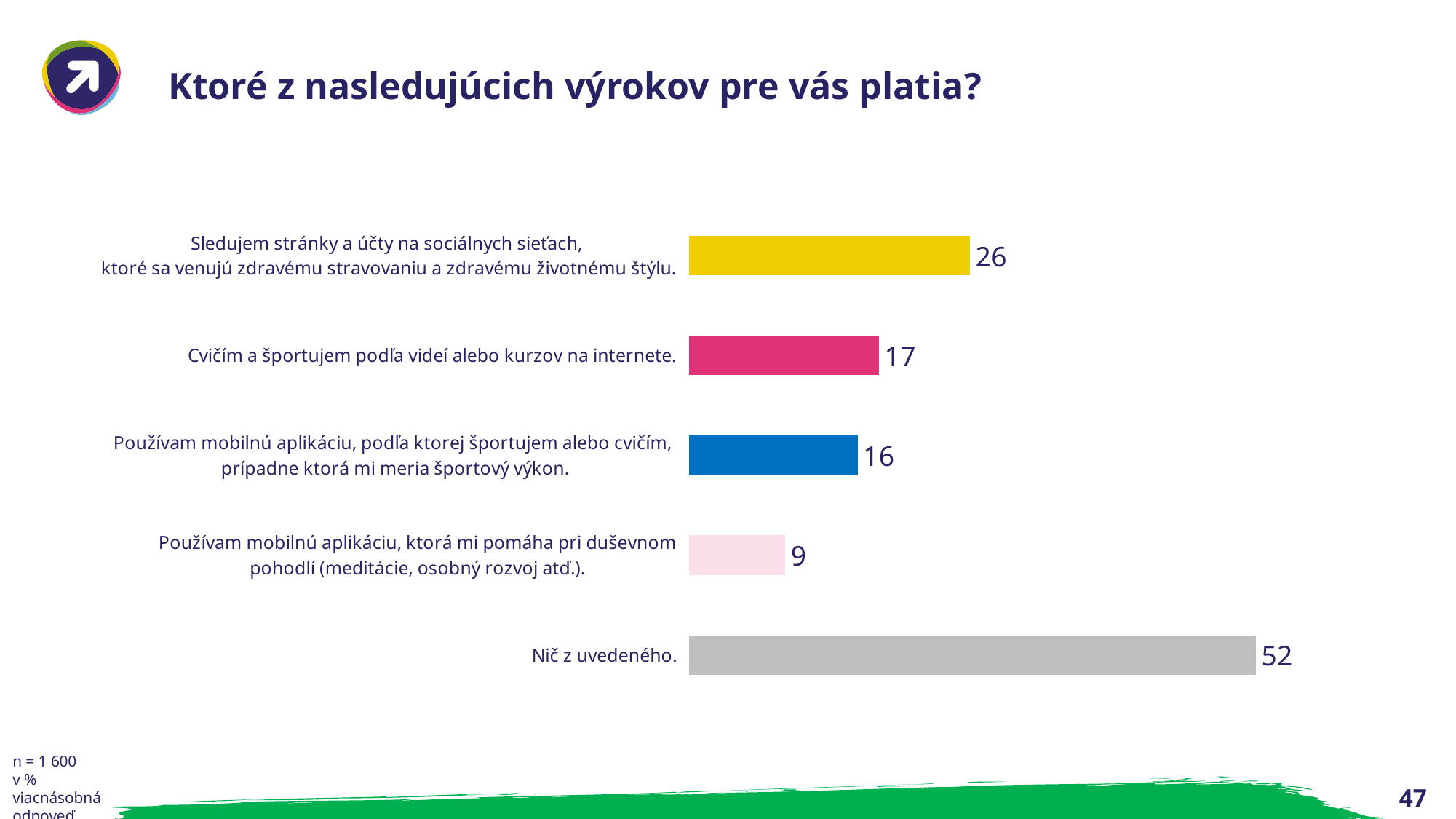
What is the difference between the value for "Nič z uvedeného." and the value for following social network pages about healthy eating and lifestyle? 26 Which category has the highest value? Nič z uvedeného. What value is shown for "Nič z uvedeného."? 52 What value is shown for "Cvičím a športujem podľa videí alebo kurzov na internete."? 17 Which category has the lowest value? Používam mobilnú aplikáciu, ktorá mi pomáha pri duševnom pohodlí (meditácie, osobný rozvoj atď.). What colour is the bar for "Nič z uvedeného."? Grey Which is larger: the value for exercising according to online videos or courses, or the value for using a mobile app for sport that measures performance? Cvičím a športujem podľa videí alebo kurzov na internete. What kind of chart is shown on the slide? Bar chart How many categories are shown in the chart? 5 What is the title of the slide? Ktoré z nasledujúcich výrokov pre vás platia? What value is shown for the statement about following pages and accounts on social networks devoted to healthy eating and lifestyle? 26 What value is shown for using a mobile app that helps with mental well-being (meditation, personal development etc.)? 9